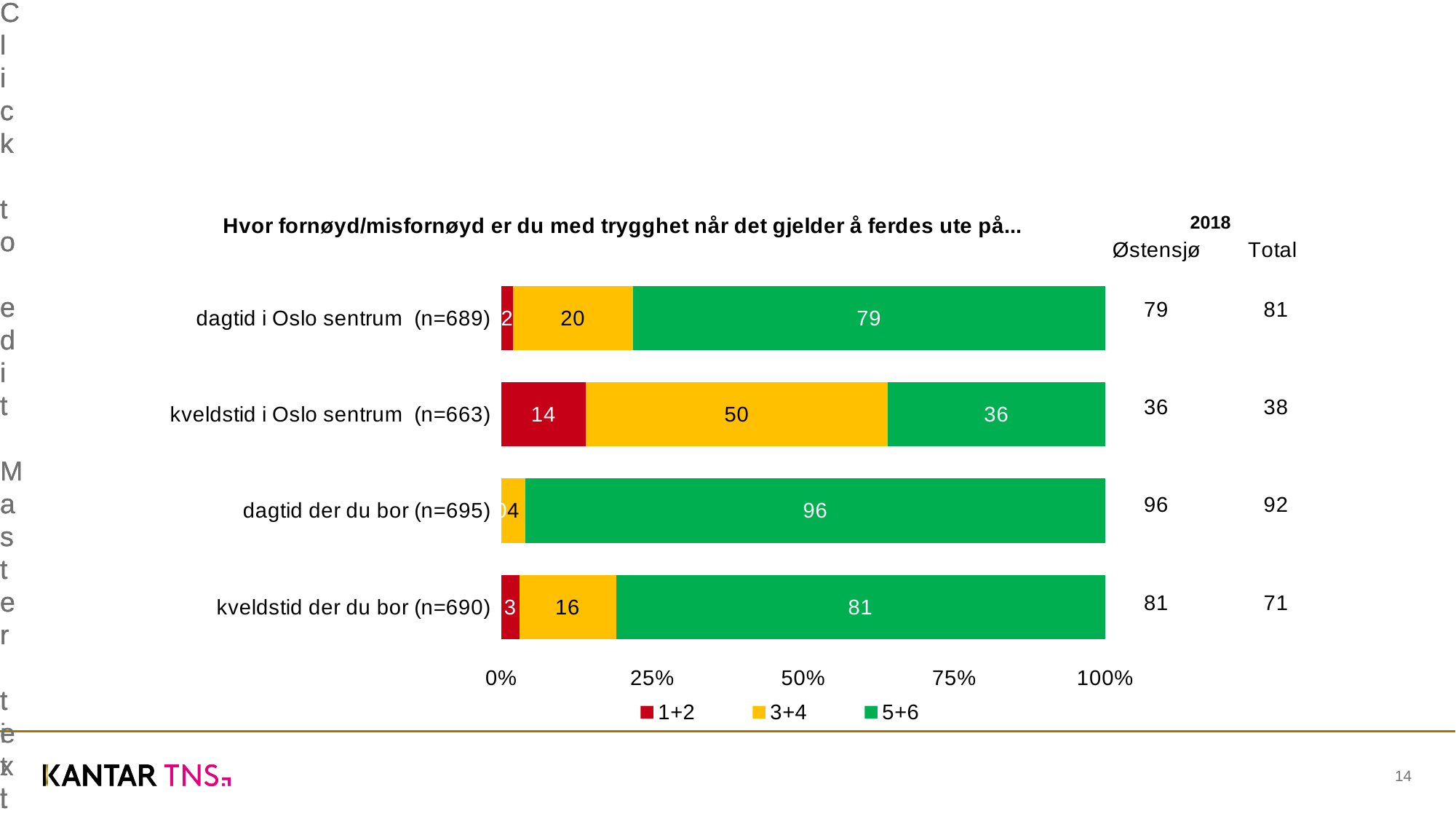
Which category has the highest value for the 5+6 series? dagtid der du bor (n=695) What is the value of the 3+4 series for 'dagtid i Oslo sentrum (n=689)'? 20 Which category has the lowest value for the 5+6 series? kveldstid i Oslo sentrum (n=663) What kind of chart is shown on the slide? Stacked bar chart How many series does the legend list? 3 Which is larger: the 1+2 value for 'kveldstid i Oslo sentrum (n=663)' or for 'dagtid i Oslo sentrum (n=689)'? kveldstid i Oslo sentrum (n=663) What is the value of the 1+2 series for 'kveldstid der du bor (n=690)'? 3 What colour represents the 5+6 series in the chart? Green What is the value of the 5+6 series for 'kveldstid i Oslo sentrum (n=663)'? 36 Is the 5+6 value for 'kveldstid der du bor (n=690)' greater or less than 75%? greater What is the difference between the 3+4 values for 'kveldstid i Oslo sentrum (n=663)' and 'kveldstid der du bor (n=690)'? 34 How many categories are plotted in the chart? 4